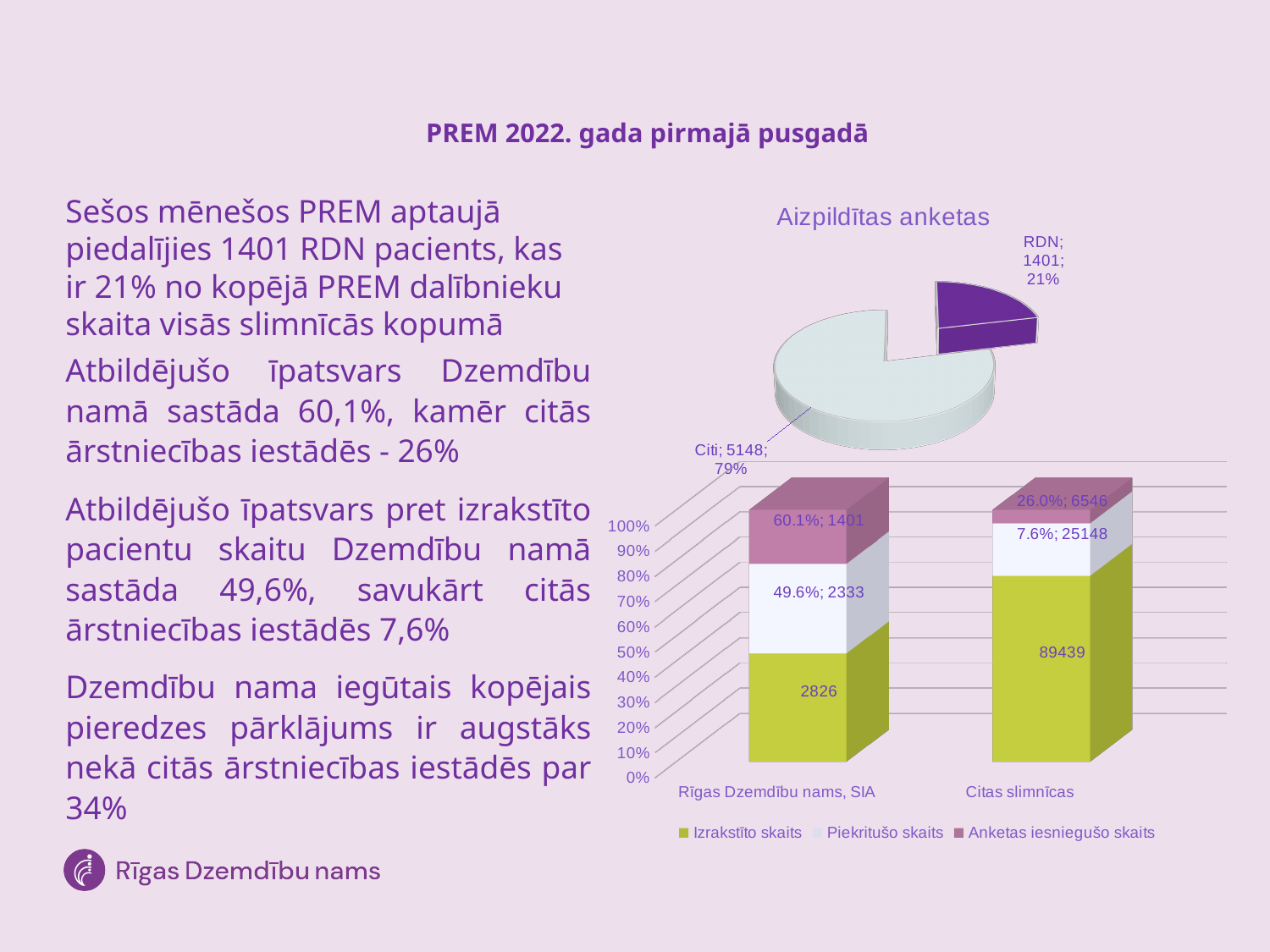
In the stacked bar chart at the bottom right, how many series does the legend list? 3 In the stacked bar chart at the bottom right, what is the Izrakstīto skaits value for Rīgas Dzemdību nams, SIA? 2826 In the stacked bar chart at the bottom right, what label is shown on the Anketas iesniegušo skaits segment for Rīgas Dzemdību nams, SIA? 60.1%; 1401 In the pie chart titled "Aizpildītas anketas", how many slices are there? 2 In the stacked bar chart at the bottom right, what is the Izrakstīto skaits value for Citas slimnīcas? 89439 In the pie chart titled "Aizpildītas anketas", what is the difference between the Citi value and the RDN value? 3747 In the pie chart titled "Aizpildītas anketas", what value is shown for RDN? 1401 What type of chart is the chart at the bottom right of the slide? Bar chart What type of chart is the chart titled "Aizpildītas anketas"? Pie chart In the stacked bar chart at the bottom right, what label is shown on the Piekritušo skaits segment for Citas slimnīcas? 7.6%; 25148 In the pie chart titled "Aizpildītas anketas", what share of the pie does the Citi slice represent? 79% In the stacked bar chart at the bottom right, which category has the larger Izrakstīto skaits value, Rīgas Dzemdību nams, SIA or Citas slimnīcas? Citas slimnīcas